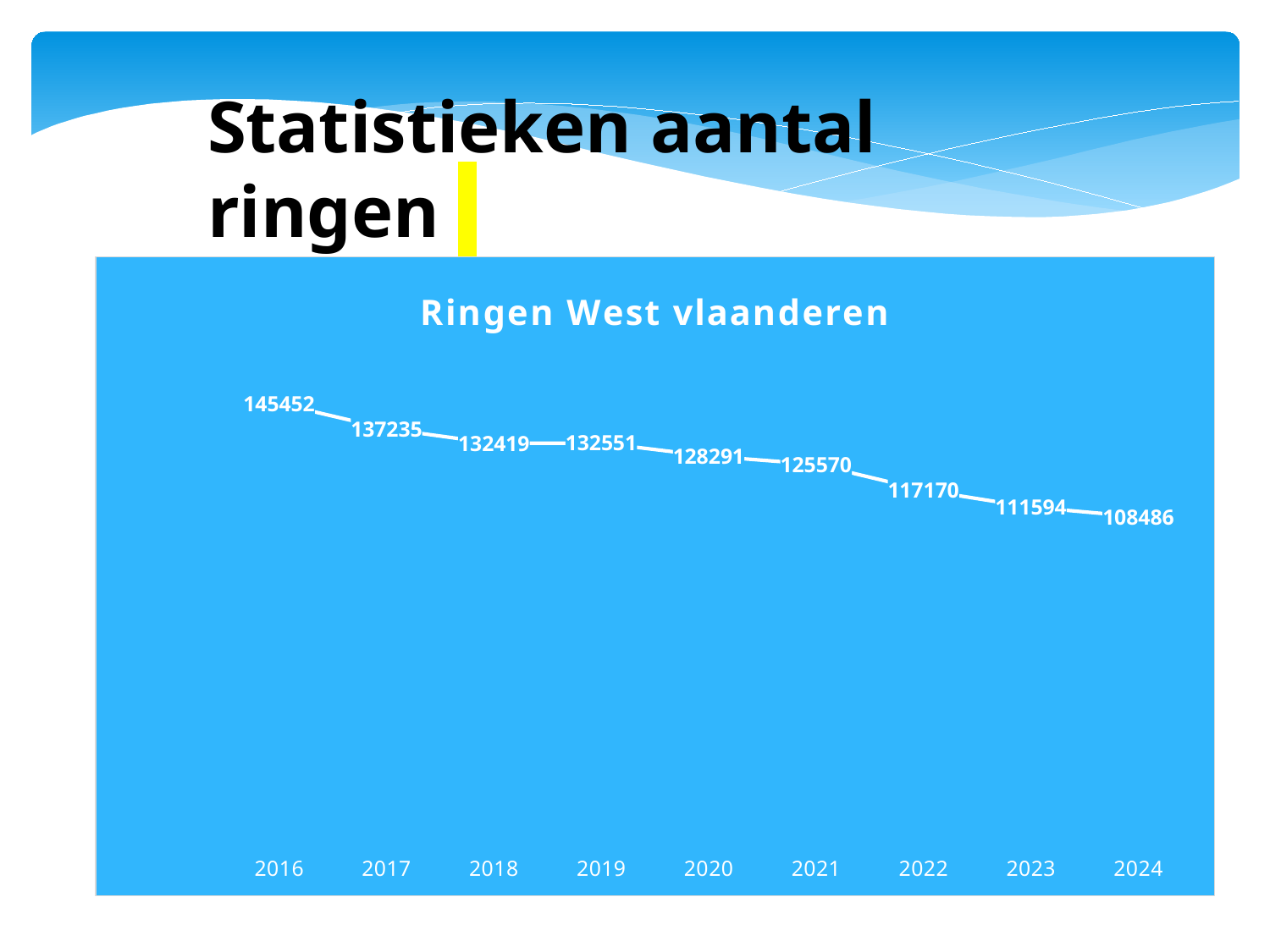
Which is larger, the value for 2018 or the value for 2019? 2019 What is the value for 2020? 128291 What is the value for 2016? 145452 What kind of chart is this? line chart What is the difference between the values for 2016 and 2024? 36966 What is the title of the chart? Ringen West vlaanderen Do the values generally rise or fall from 2016 to 2024? fall What is the difference between the values for 2021 and 2022? 8400 What is the value for 2024? 108486 Which year has the highest value? 2016 Which year has the lowest value? 2024 How many years are plotted on the chart? 9